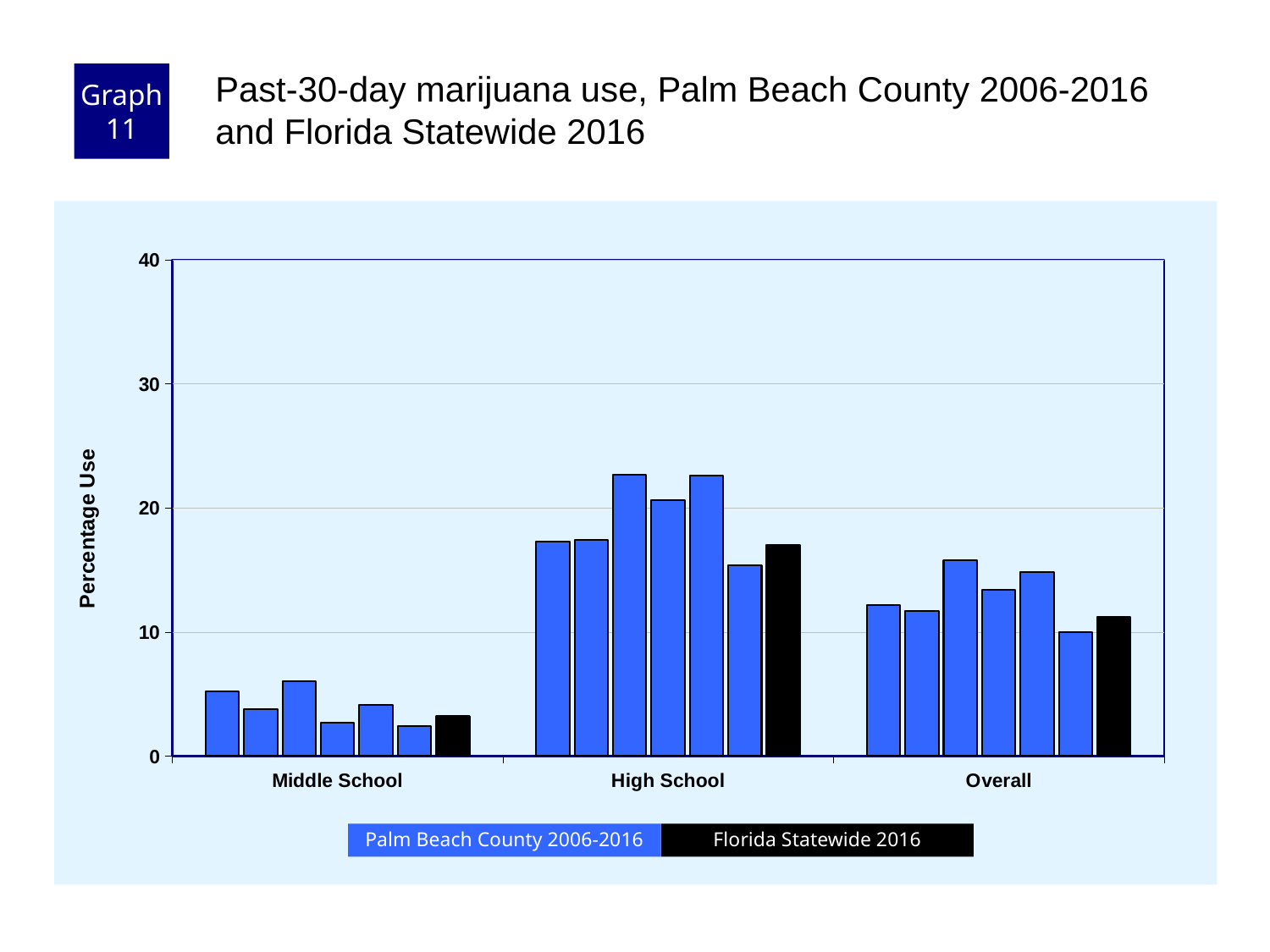
What kind of chart is shown on the slide? bar chart Are all the Palm Beach County 2006-2016 values for High School greater or less than 30? less Is the Florida Statewide 2016 value for High School greater or less than 10? greater What colour represents Florida Statewide 2016 in the legend? black Is the Florida Statewide 2016 value for Middle School greater or less than 10? less Which category has the lowest bars overall? Middle School Which is larger, the Florida Statewide 2016 value for High School or for Middle School? High School How many categories are shown on the x axis? 3 What is the label on the y axis? Percentage Use How many series does the legend list? 2 Which category has the highest bars overall? High School